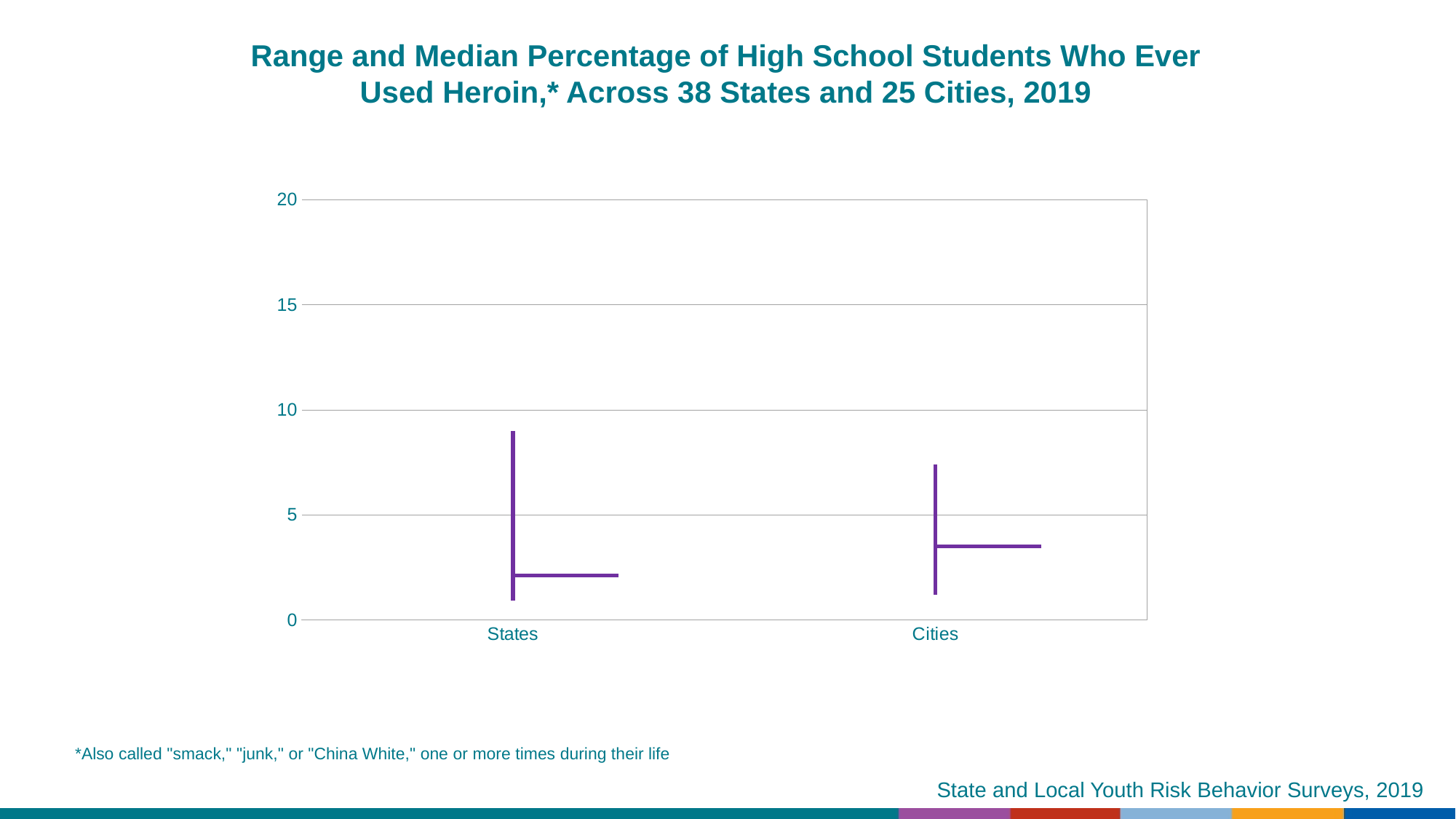
What is the maximum value shown on the y axis? 20 Is the median for States greater or less than 5? less What is the title of the chart? Range and Median Percentage of High School Students Who Ever Used Heroin,* Across 38 States and 25 Cities, 2019 Is the median for Cities greater or less than 5? less Is the highest value of the range for States greater or less than 10? less Which category has the higher top of its range, States or Cities? States Which category has the wider range of values? States How many categories are shown on the x axis of the chart? 2 Which category has the higher median, States or Cities? Cities What are the two categories shown on the x axis? States and Cities